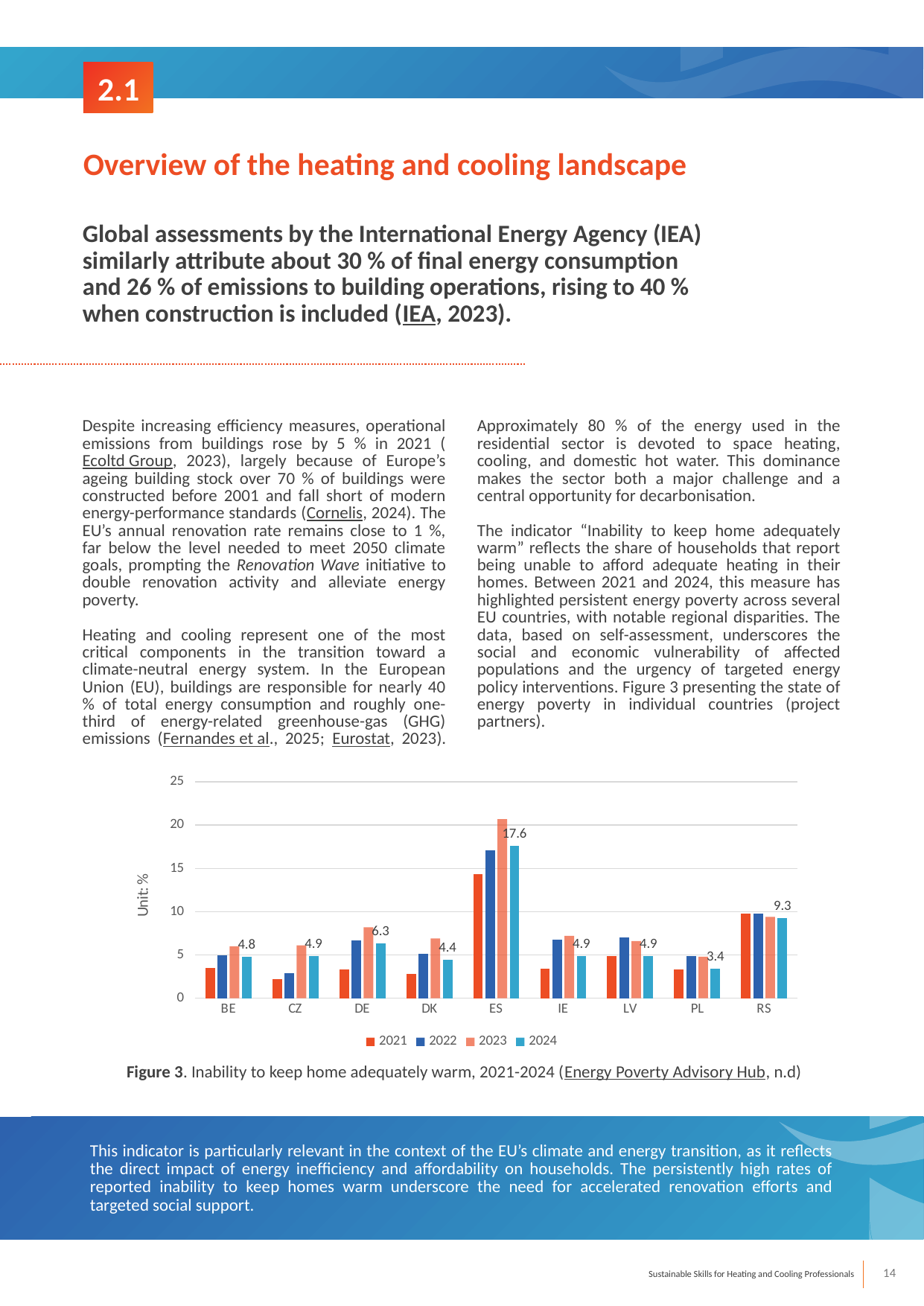
What kind of chart is shown in Figure 3? Bar chart What is the 2024 value for RS? 9.3 Which is larger, the 2024 value for DE or the 2024 value for DK? DE What is the 2024 value for ES? 17.6 What is the 2024 value for PL? 3.4 Which country has the lowest 2024 value? PL What is the difference between the 2024 values for DE and DK? 1.9 How many countries are shown on the x axis? 9 Which country has the highest 2024 value? ES Is the 2021 value for ES greater or less than 10? greater How many series does the legend list? 4 What is the difference between the 2024 values for ES and RS? 8.3